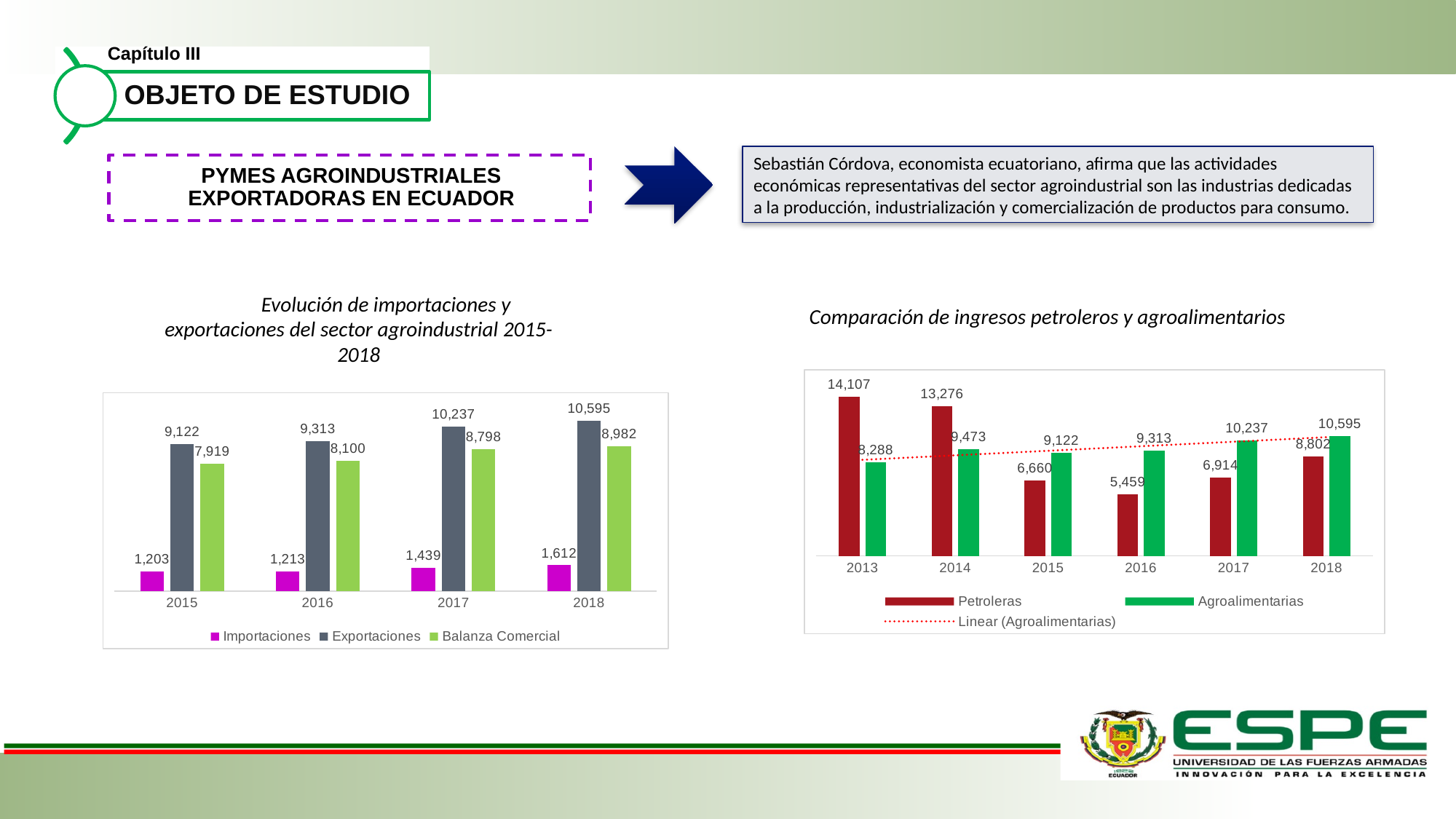
In the left chart (Evolución de importaciones y exportaciones), do the Exportaciones values rise or fall from 2015 to 2018? rise In the left chart (Evolución de importaciones y exportaciones del sector agroindustrial 2015-2018), what is the value of Exportaciones in 2017? 10,237 In the left chart (Evolución de importaciones y exportaciones), which year has the highest Balanza Comercial? 2018 In the right chart (Comparación de ingresos petroleros y agroalimentarios), what is the value of Agroalimentarias in 2014? 9,473 In the right chart (Comparación de ingresos petroleros y agroalimentarios), what is the value of Petroleras in 2016? 5,459 In the right chart (Comparación de ingresos petroleros y agroalimentarios), what is the difference between Agroalimentarias and Petroleras in 2018? 1,793 In the left chart (Evolución de importaciones y exportaciones), what is the value of Importaciones in 2016? 1,213 In the right chart (Comparación de ingresos petroleros y agroalimentarios), which year has the lowest Petroleras value? 2016 What type of chart is the right chart (Comparación de ingresos petroleros y agroalimentarios)? bar chart In the right chart (Comparación de ingresos petroleros y agroalimentarios), which is larger in 2013, Petroleras or Agroalimentarias? Petroleras In the left chart (Evolución de importaciones y exportaciones), how many series does the legend list? 3 In the left chart (Evolución de importaciones y exportaciones), what is the difference between Exportaciones and Importaciones in 2015? 7,919